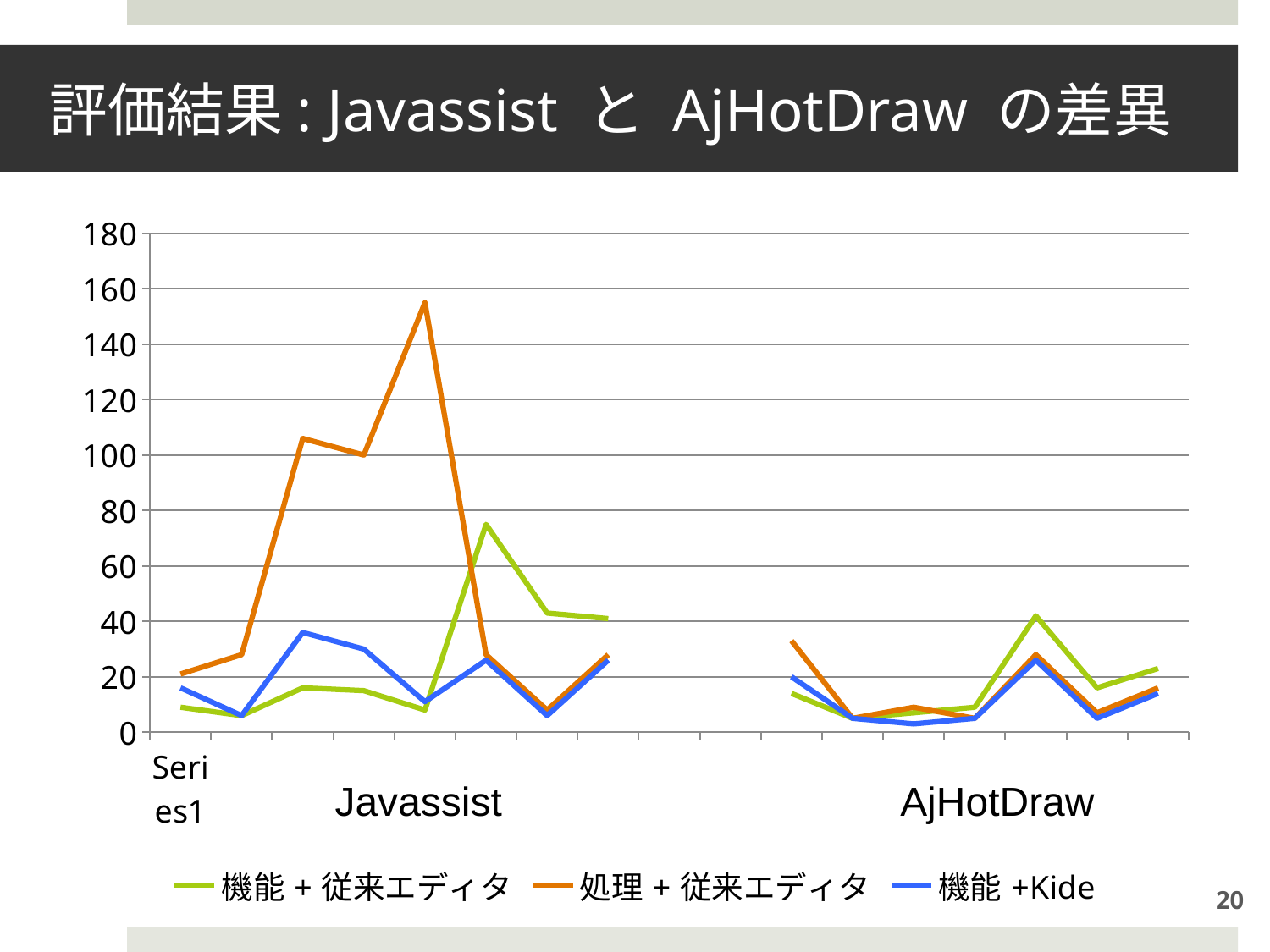
What kind of chart is shown on the slide? line chart Which series has the lowest peak value across the whole chart? 機能＋Kide Is the peak value of the 処理＋従来エディタ series in the Javassist group greater or less than 140? greater What is the title of the slide containing the chart? 評価結果：Javassist と AjHotDraw の差異 Which series reaches the highest value anywhere on the chart? 処理＋従来エディタ How many series does the legend list? 3 Which series is drawn in orange according to the legend? 処理＋従来エディタ In the AjHotDraw group, is the highest value of the 機能＋従来エディタ series greater or less than 60? less What is the maximum value shown on the vertical axis? 180 Which series has the larger peak in the Javassist group, 処理＋従来エディタ or 機能＋Kide? 処理＋従来エディタ Is the peak value of the 機能＋従来エディタ series in the Javassist group greater or less than 60? greater